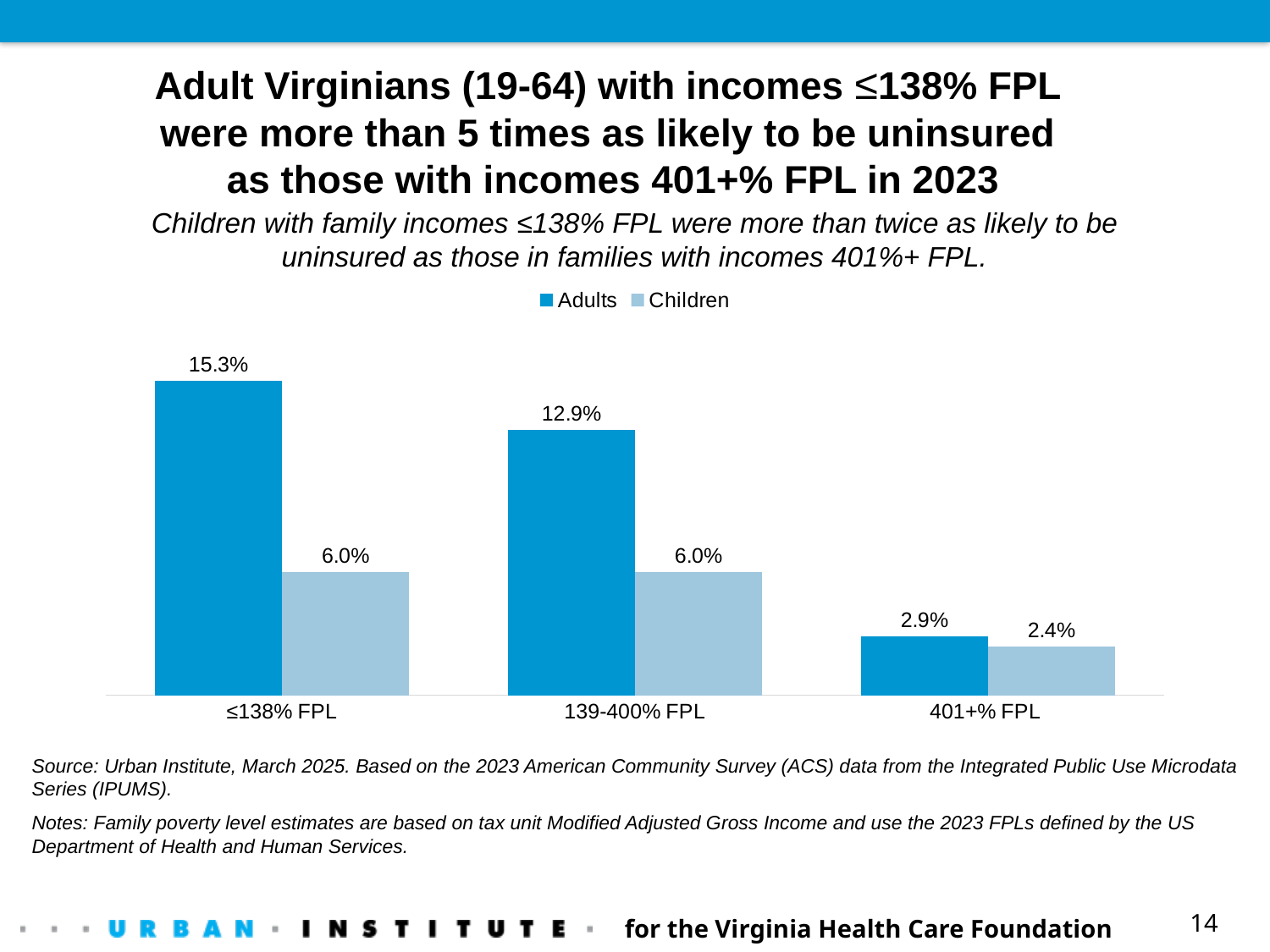
What is the difference between the Adults values for ≤138% FPL and 139-400% FPL? 2.4% Which is larger in the 139-400% FPL group, the Adults value or the Children value? Adults What is the value for Adults in the 401+% FPL group? 2.9% Which income group has the highest uninsured rate for Adults? ≤138% FPL What is the uninsured rate for Adults with incomes ≤138% FPL? 15.3% What is the difference between the Adults and Children values in the ≤138% FPL group? 9.3% What is the value for Children in the 401+% FPL group? 2.4% What is the uninsured rate for Children in the 139-400% FPL group? 6.0% What kind of chart is shown on the slide? Bar chart Which income group has the lowest uninsured rate for Children? 401+% FPL How many series does the legend list? 2 How many income groups are shown on the x axis? 3